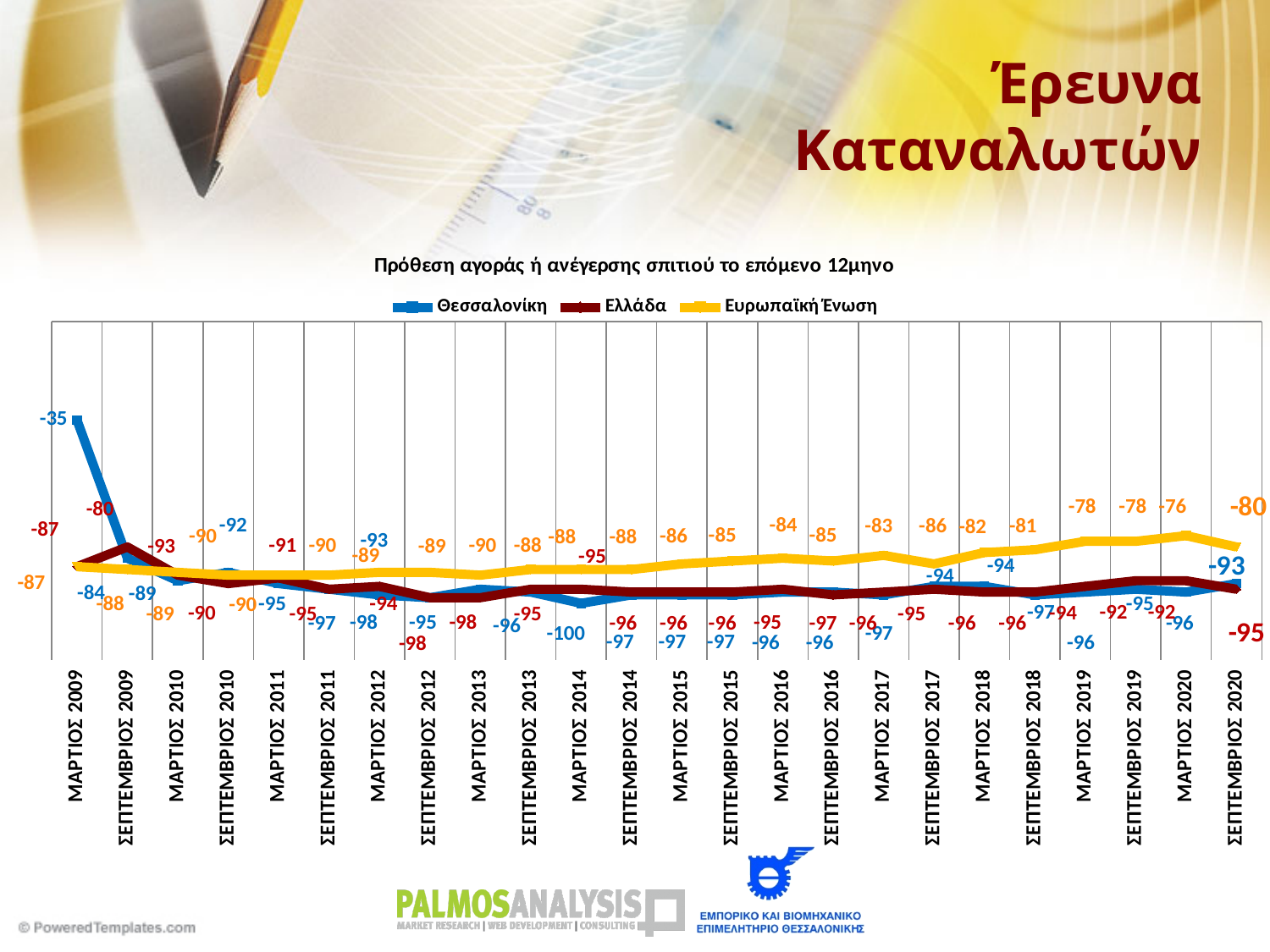
What is the value for Θεσσαλονίκη in ΜΑΡΤΙΟΣ 2009? -35 How many time points are plotted along the x axis? 24 At which time point does Ευρωπαϊκή Ένωση reach its highest value? ΜΑΡΤΙΟΣ 2020 At which time point does Θεσσαλονίκη reach its lowest value? ΜΑΡΤΙΟΣ 2014 In ΣΕΠΤΕΜΒΡΙΟΣ 2020, which is higher: Θεσσαλονίκη or Ελλάδα? Θεσσαλονίκη What is the value for Ελλάδα in ΣΕΠΤΕΜΒΡΙΟΣ 2020? -95 What is the title of the chart? Πρόθεση αγοράς ή ανέγερσης σπιτιού το επόμενο 12μηνο What is the difference between the Ευρωπαϊκή Ένωση and Ελλάδα values in ΣΕΠΤΕΜΒΡΙΟΣ 2020? 15 What is the value for Ευρωπαϊκή Ένωση in ΣΕΠΤΕΜΒΡΙΟΣ 2020? -80 What type of chart is shown on the slide? Line chart How many series does the legend list? 3 What is the value for Θεσσαλονίκη in ΣΕΠΤΕΜΒΡΙΟΣ 2020? -93